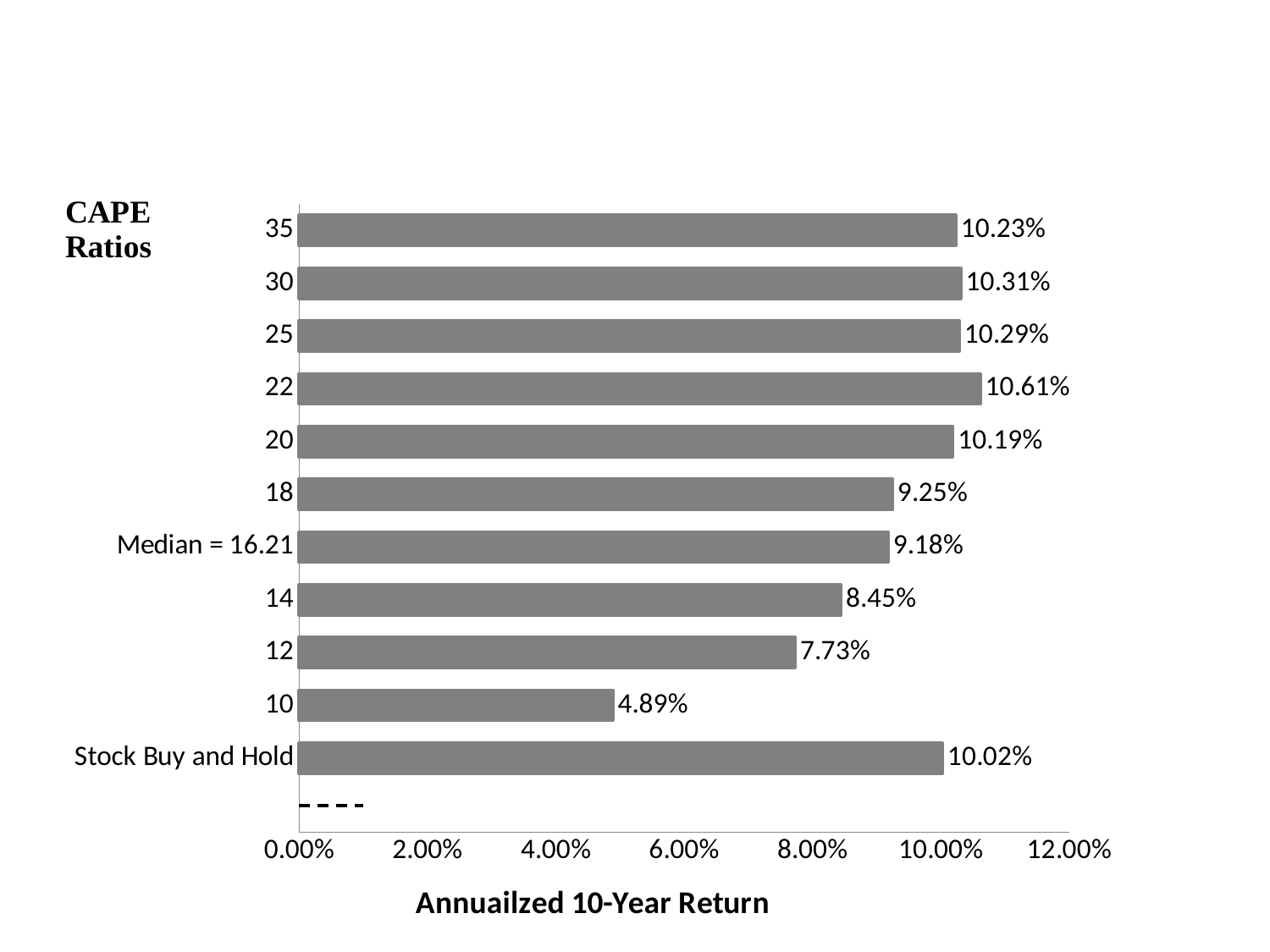
How many categories are plotted in the chart? 11 What is the label of the horizontal axis? Annuailzed 10-Year Return What is the annualized 10-year return for Stock Buy and Hold? 10.02% Which category has the highest annualized 10-year return? 22 Which has a higher annualized 10-year return, CAPE ratio 18 or CAPE ratio 14? 18 Which category has the lowest annualized 10-year return? 10 What kind of chart is shown on the slide? bar chart What is the difference between the returns for CAPE ratios 14 and 12? 0.72% What is the annualized 10-year return for the Median = 16.21 category? 9.18% What is the annualized 10-year return for a CAPE ratio of 10? 4.89% Is the value for CAPE ratio 12 greater or less than 8.00%? less What is the annualized 10-year return for a CAPE ratio of 22? 10.61%